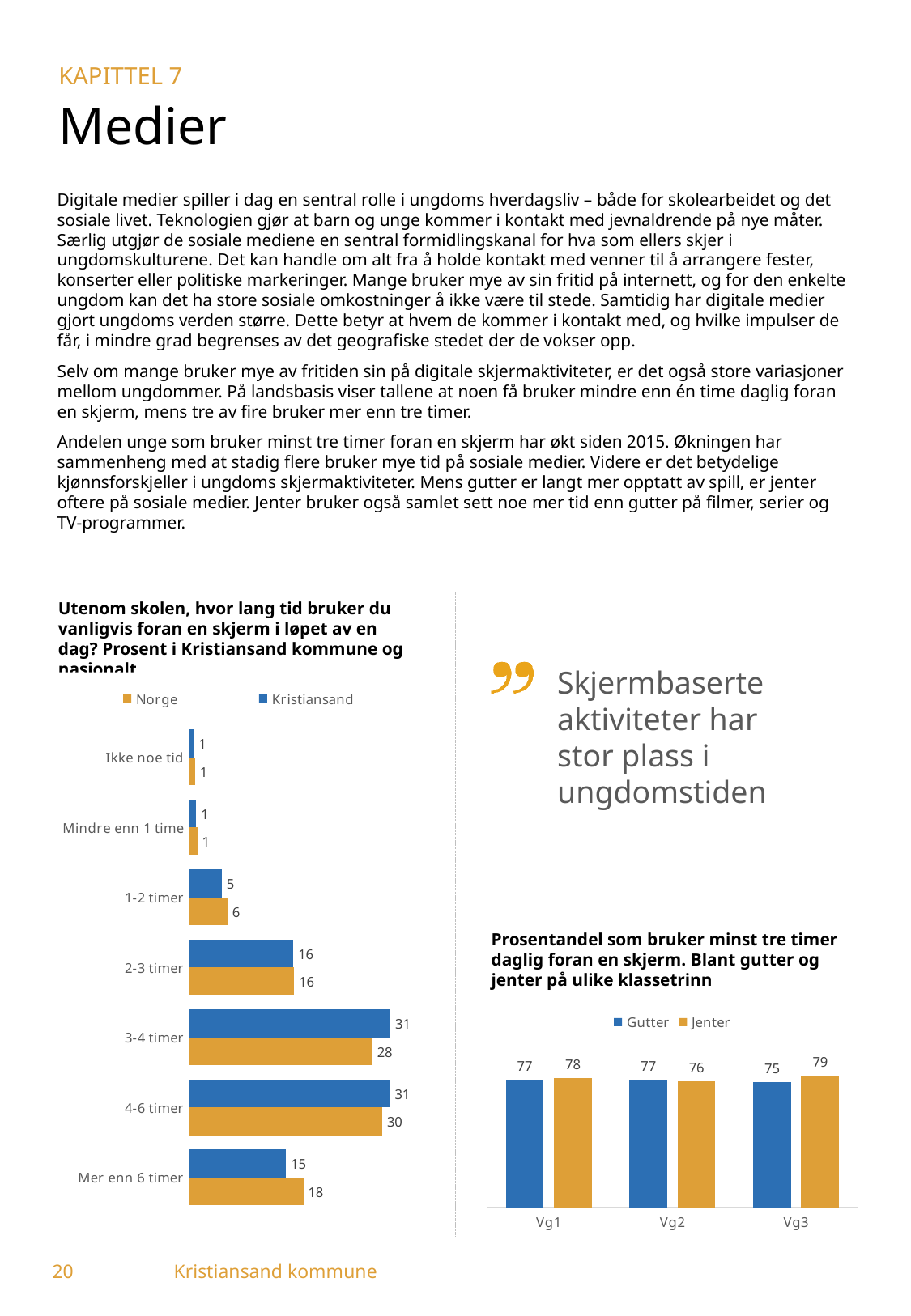
In the left chart (Utenom skolen, hvor lang tid bruker du vanligvis foran en skjerm...), how many series does the legend list? 2 In the left chart (Utenom skolen, hvor lang tid bruker du vanligvis foran en skjerm...), how many categories are shown? 7 In the right chart (Prosentandel som bruker minst tre timer daglig foran en skjerm), which class level has the lowest value for Gutter? Vg3 In the right chart (Prosentandel som bruker minst tre timer daglig foran en skjerm), which colour represents Jenter in the legend? Orange In the right chart (Prosentandel som bruker minst tre timer daglig foran en skjerm), what is the difference between Jenter and Gutter at Vg3? 4 In the right chart (Prosentandel som bruker minst tre timer daglig foran en skjerm), what is the value for Gutter at Vg2? 77 In the right chart (Prosentandel som bruker minst tre timer daglig foran en skjerm), what is the value for Jenter at Vg3? 79 In the left chart (Utenom skolen, hvor lang tid bruker du vanligvis foran en skjerm...), what is the difference between Norge and Kristiansand for '3-4 timer'? 3 What kind of chart is the left chart (Utenom skolen, hvor lang tid bruker du vanligvis foran en skjerm...)? Bar chart In the left chart (Utenom skolen, hvor lang tid bruker du vanligvis foran en skjerm...), what is the value for Norge in the 'Mer enn 6 timer' category? 18 In the left chart (Utenom skolen, hvor lang tid bruker du vanligvis foran en skjerm...), what is the value for Kristiansand in the '3-4 timer' category? 31 In the left chart (Utenom skolen, hvor lang tid bruker du vanligvis foran en skjerm...), which is larger for 'Mer enn 6 timer': Norge or Kristiansand? Norge